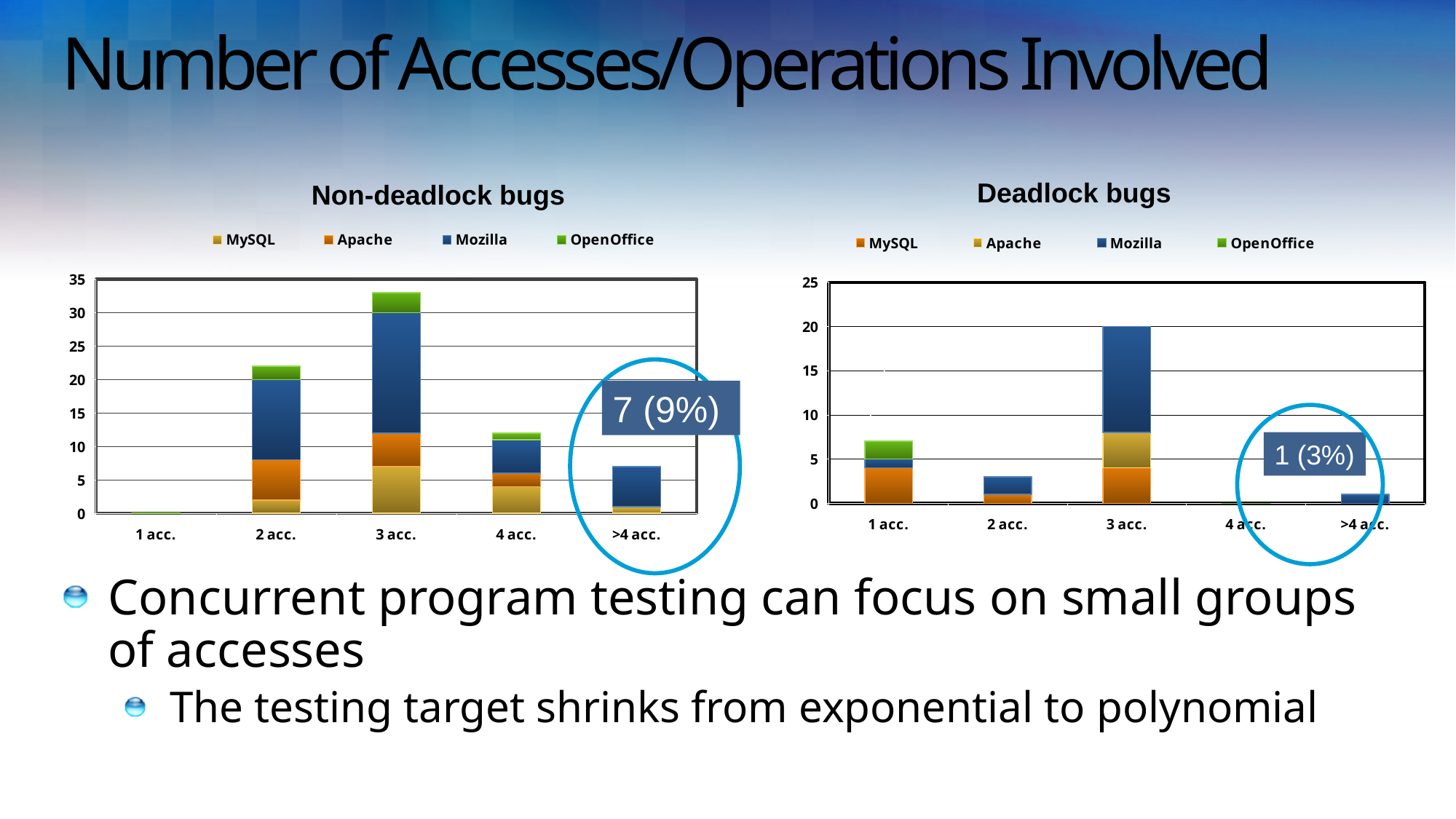
What kind of chart is the Non-deadlock bugs chart? bar chart How many series does the legend of the Non-deadlock bugs chart list? 4 In the Non-deadlock bugs chart, which stacked bar is taller: 2 acc. or 4 acc.? 2 acc. Which series are listed in the legend of the Deadlock bugs chart? MySQL, Apache, Mozilla, OpenOffice In the Non-deadlock bugs chart, is the total for 3 acc. greater or less than 30? greater In the Deadlock bugs chart, which category has the lowest total? 4 acc. In the Deadlock bugs chart, which category has the tallest stacked bar? 3 acc. In the Deadlock bugs chart, is the total for 1 acc. greater or less than 10? less How many categories are shown on the x axis of the Deadlock bugs chart? 5 In the Non-deadlock bugs chart, which category has the tallest stacked bar? 3 acc. In the Non-deadlock bugs chart, what value is annotated for the >4 acc. bar? 7 (9%) In the Deadlock bugs chart, what value is annotated for the >4 acc. bar? 1 (3%)